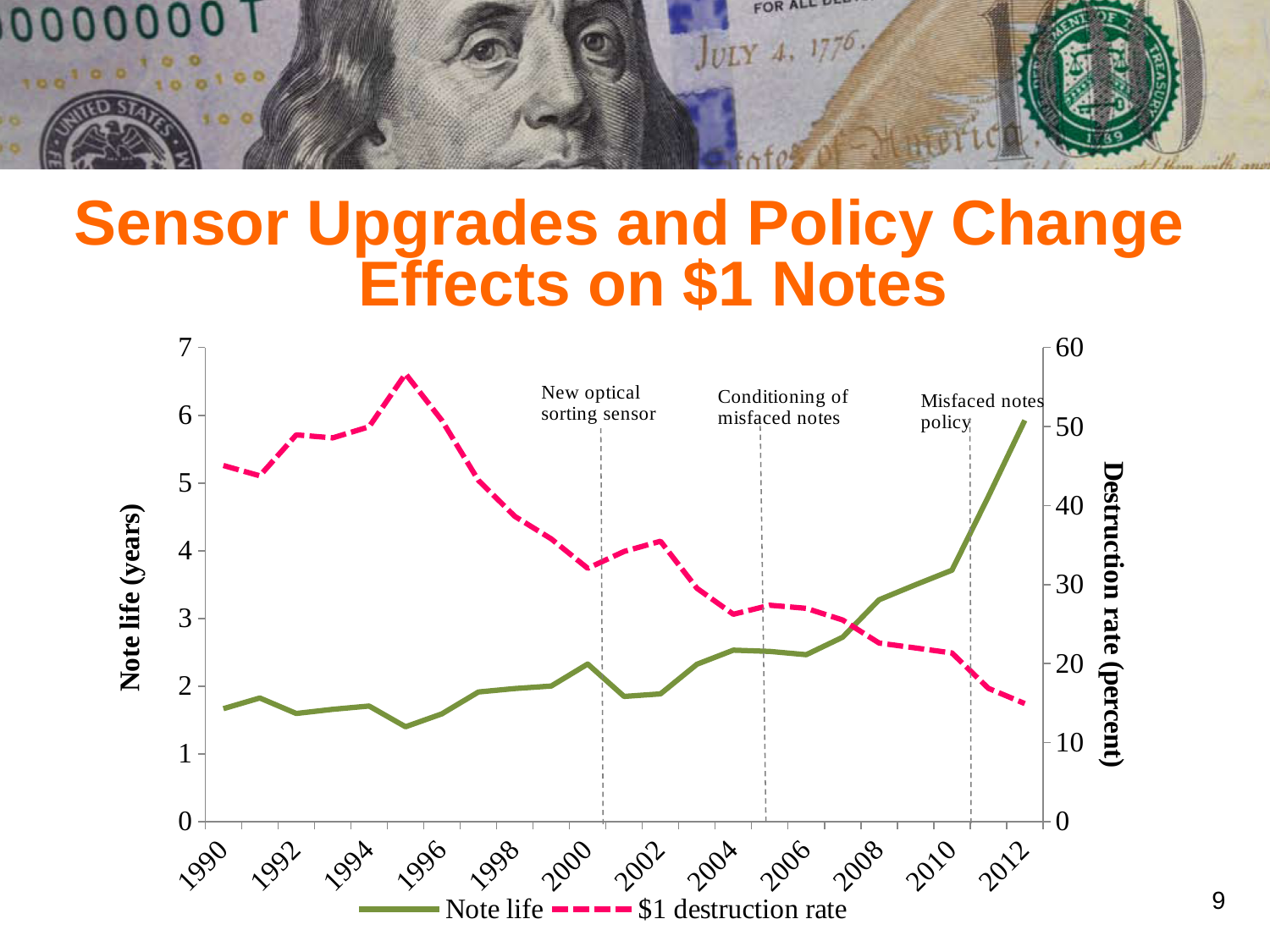
How many series does the legend list? 2 In which year does the $1 destruction rate reach its highest value? 1995 Does the $1 destruction rate series rise or fall overall from 1990 to 2012? Fall Which series does the dashed pink line represent? $1 destruction rate Is the Note life value for 2012 greater or less than 5 years? greater Does the Note life series rise or fall overall from 1990 to 2012? Rise Is the $1 destruction rate for 1995 greater or less than 50 percent? greater What is the title of the left vertical axis? Note life (years) What kind of chart is shown on the slide? Line chart Is the $1 destruction rate for 2012 greater or less than 20 percent? less In which year does Note life reach its highest value? 2012 Which year has the higher Note life, 1990 or 2012? 2012